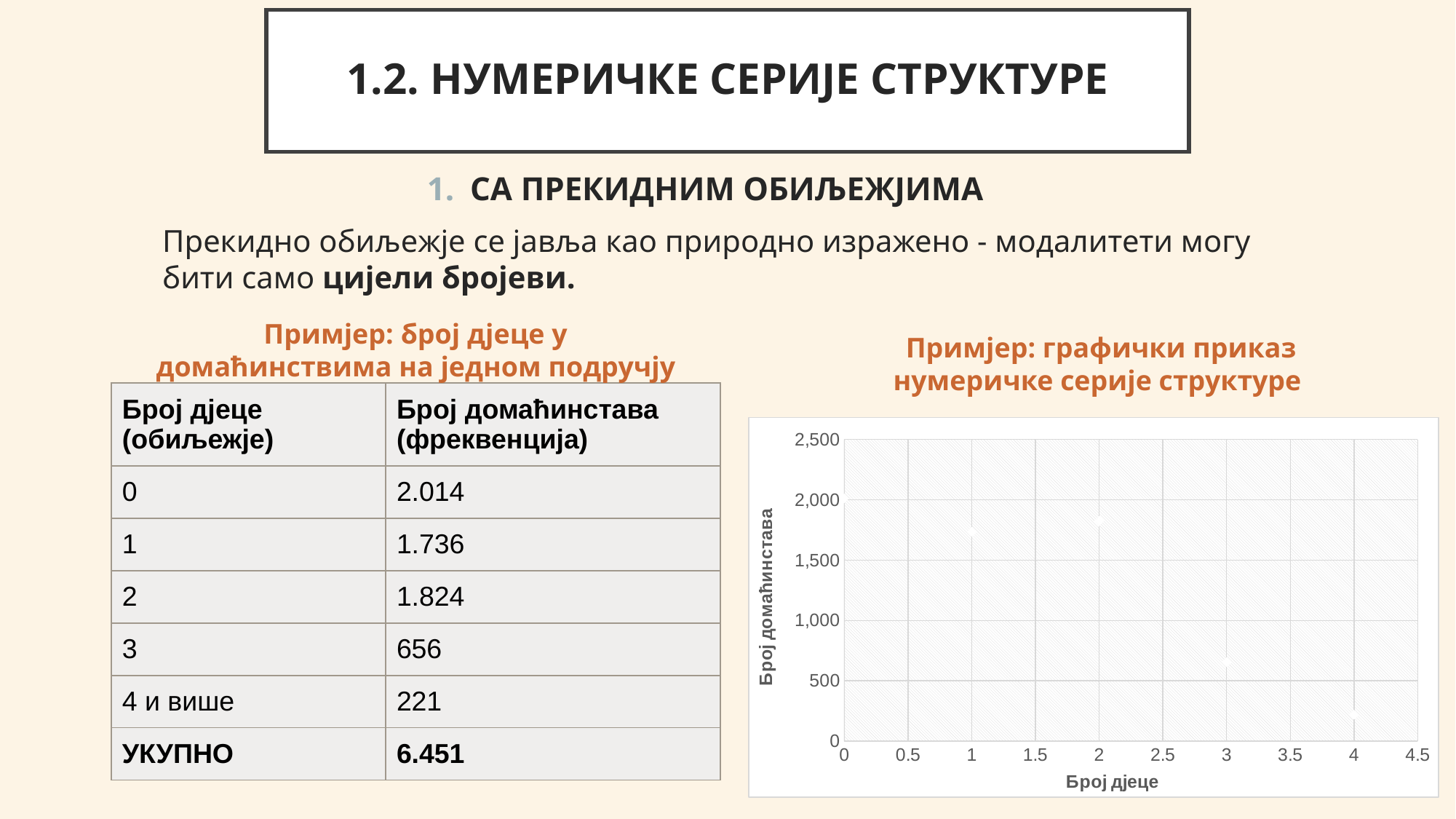
Do the plotted values rise or fall from x = 2 to x = 4? fall Which is larger, the value plotted at x = 2 or the value plotted at x = 4? x = 2 Is the value plotted at x = 2 greater or less than 1,500? greater Is the value plotted at x = 3 greater or less than 1,000? less Which is larger, the value plotted at x = 1 or the value plotted at x = 3? x = 1 What is the title of the y axis of the chart? Број домаћинстава What kind of chart is shown on the slide? scatter chart Is the value plotted at x = 1 greater or less than 1,500? greater What is the title of the x axis of the chart? Број дјеце Which is larger, the value plotted at x = 3 or the value plotted at x = 4? x = 3